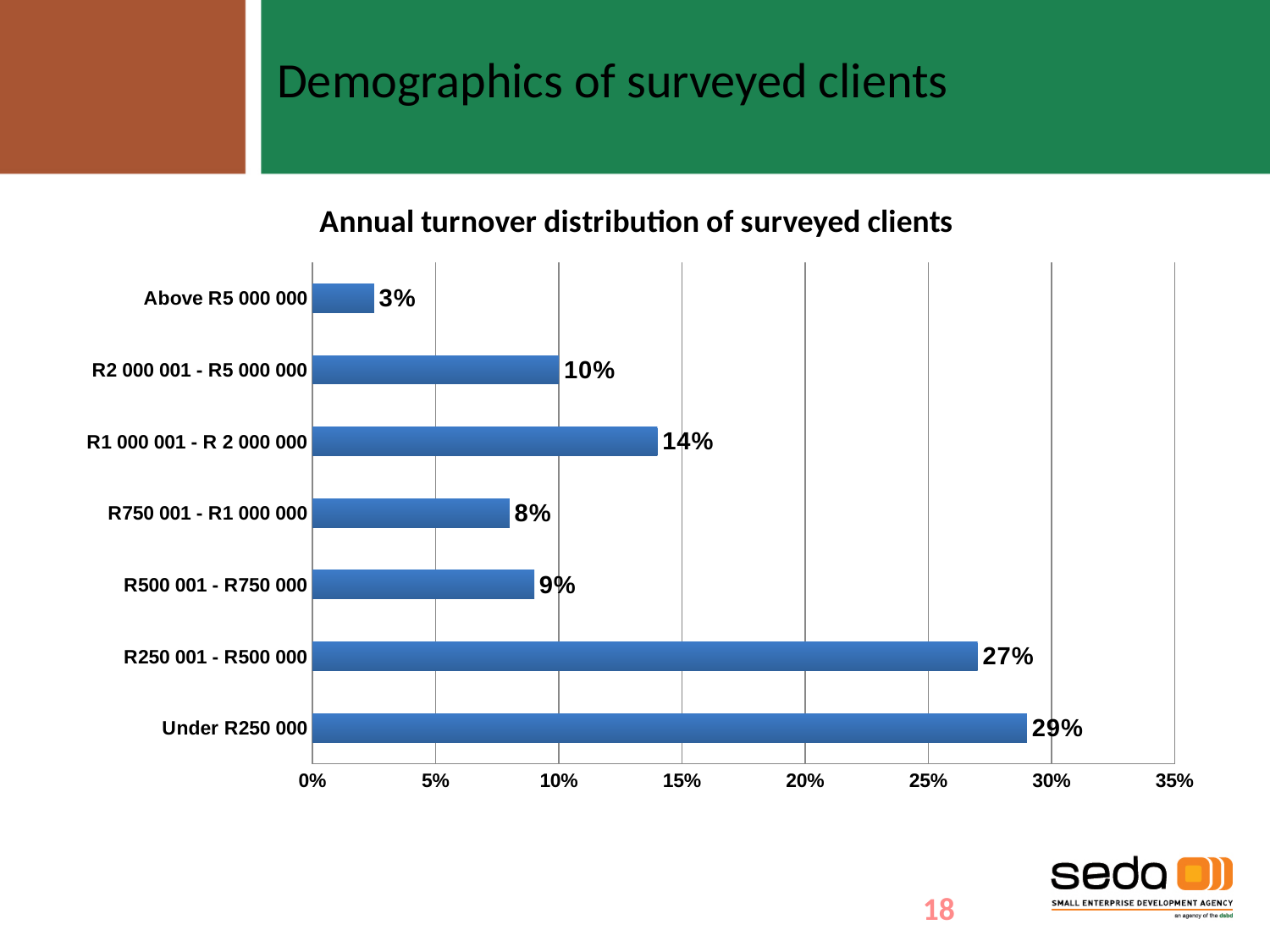
What is the value for Under R250 000? 29% Which turnover category has the lowest share of surveyed clients? Above R5 000 000 What is the value for Above R5 000 000? 3% Is the value for R250 001 - R500 000 greater or less than 25%? greater What is the title of the chart? Annual turnover distribution of surveyed clients Which turnover category has the highest share of surveyed clients? Under R250 000 How many turnover categories are shown in the chart? 7 What is the difference between the values for Under R250 000 and R250 001 - R500 000? 2% What is the value for R1 000 001 - R 2 000 000? 14% Which is larger, the value for R500 001 - R750 000 or the value for R750 001 - R1 000 000? R500 001 - R750 000 What kind of chart is shown on the slide? Bar chart What is the difference between the values for R1 000 001 - R 2 000 000 and R2 000 001 - R5 000 000? 4%